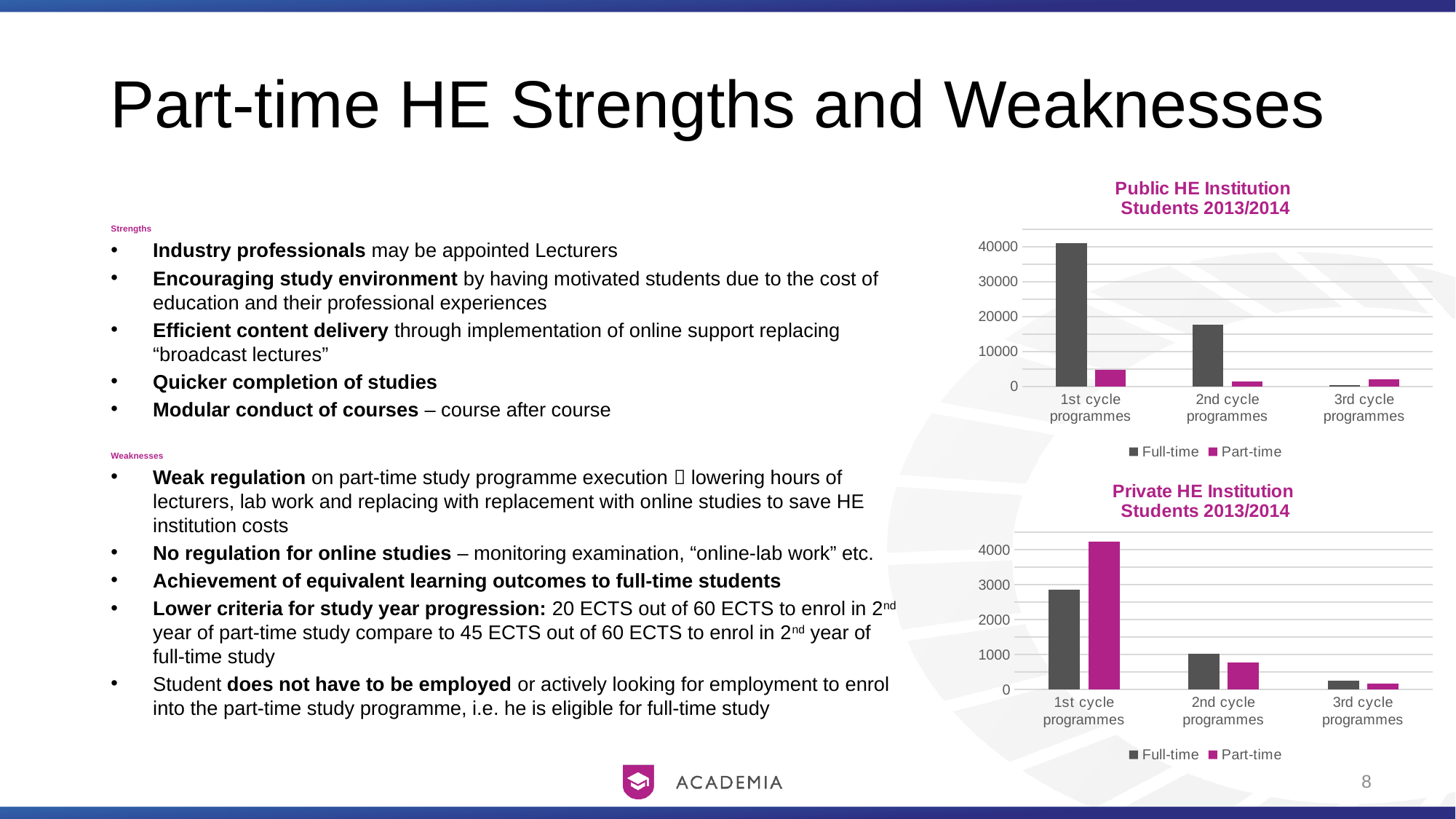
In the Private HE Institution Students 2013/2014 chart, which category has the lowest Part-time value? 3rd cycle programmes In the Public HE Institution Students 2013/2014 chart, is the Full-time value for 1st cycle programmes greater or less than 40000? greater What kind of chart is the Private HE Institution Students 2013/2014 chart? bar chart In the Private HE Institution Students 2013/2014 chart, how many categories are shown on the x axis? 3 In the Private HE Institution Students 2013/2014 chart, which is larger for 1st cycle programmes, Full-time or Part-time? Part-time In the Public HE Institution Students 2013/2014 chart, how many series does the legend list? 2 In the Public HE Institution Students 2013/2014 chart, is the Full-time value for 2nd cycle programmes greater or less than 20000? less In the Public HE Institution Students 2013/2014 chart, which is larger for 3rd cycle programmes, Full-time or Part-time? Part-time In the Private HE Institution Students 2013/2014 chart, is the Full-time value for 1st cycle programmes greater or less than 3000? less In the Public HE Institution Students 2013/2014 chart, which category has the highest Full-time value? 1st cycle programmes In the Public HE Institution Students 2013/2014 chart, what colour represents the Part-time series? magenta